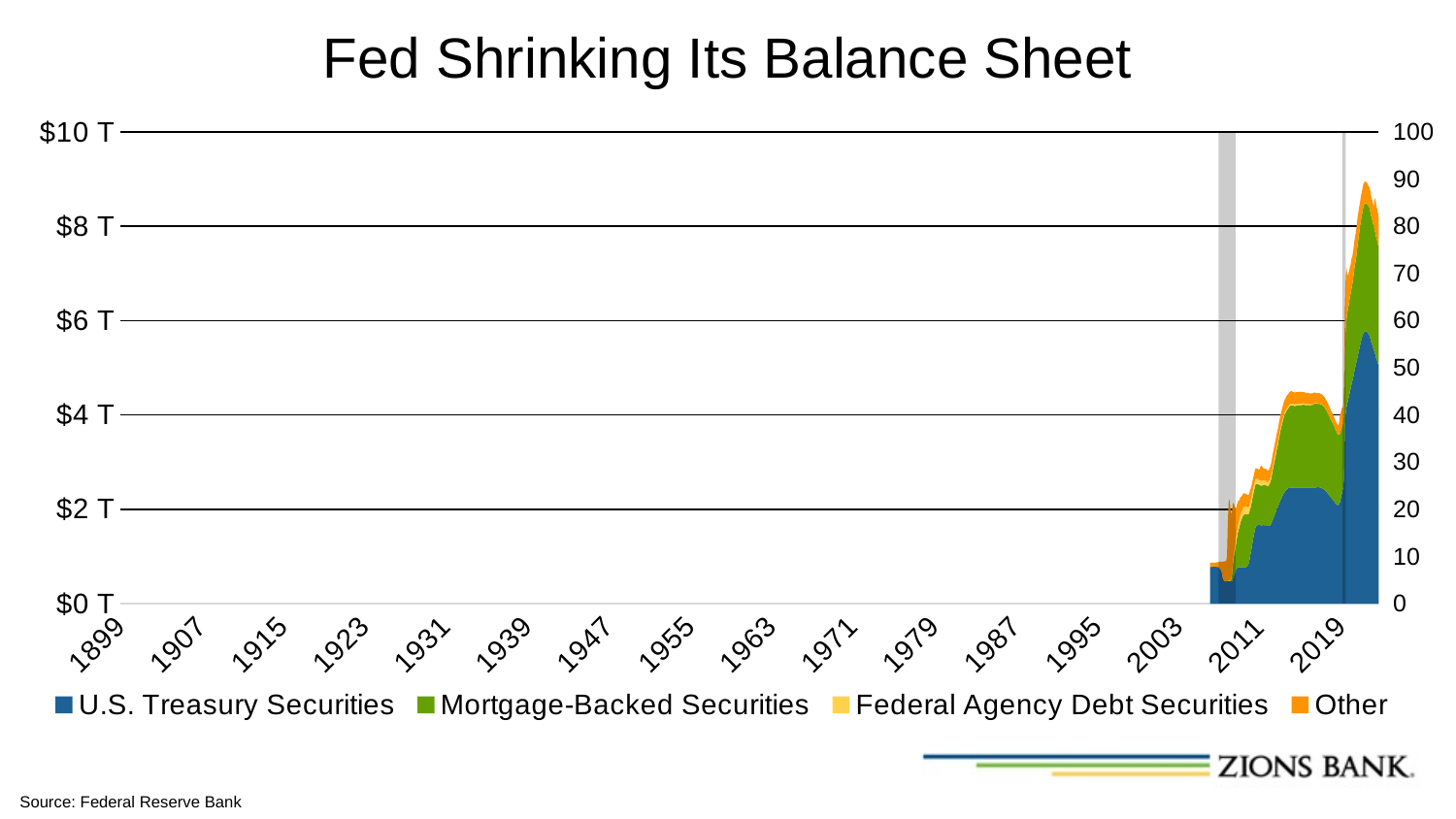
Does the total balance sheet value generally rise or fall from 2003 to its peak after 2019? rise Which series is shown in green in the legend? Mortgage-Backed Securities How many year labels are shown along the x axis? 16 Is the total value around 2015 greater or less than $6 T? less Is the total value around 2003 greater or less than $2 T? less How many series does the legend list? 4 What is the highest value shown on the right y axis? 100 Is the peak total of the stacked areas greater or less than $8 T? greater What is the highest value shown on the left y axis? $10 T What is the first year label on the x axis? 1899 What kind of chart is shown on the slide? Stacked area chart What is the title of the chart? Fed Shrinking Its Balance Sheet